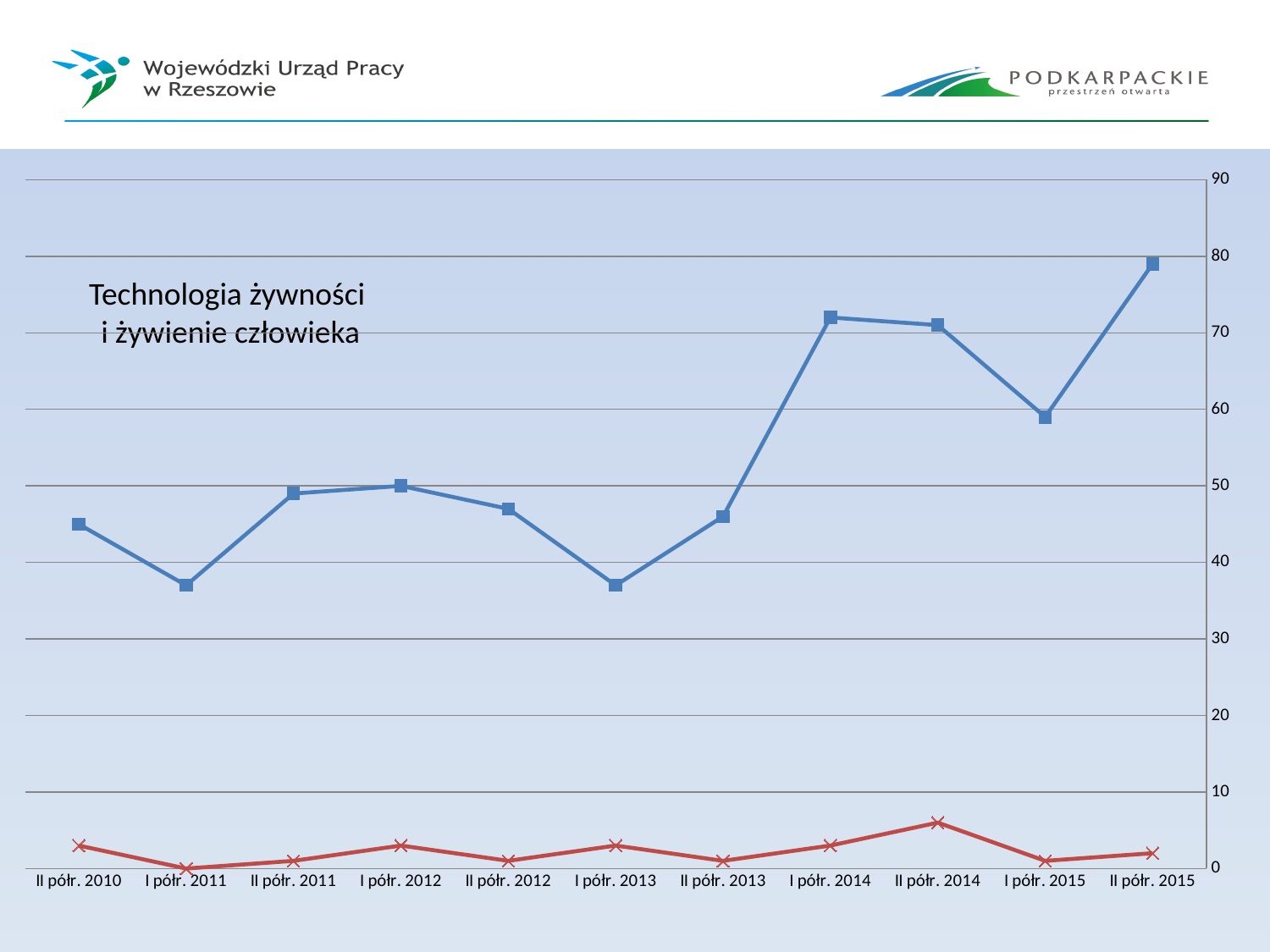
In which period does the blue line reach its highest value? II półr. 2015 Is the value of the blue line for II półr. 2015 greater or less than 70? greater On the blue line, which is larger: the value for I półr. 2014 or the value for II półr. 2013? I półr. 2014 How many data points (half-year periods) are shown along the x axis? 11 What is the title of the chart? Technologia żywności i żywienie człowieka How many lines (data series) are plotted on the chart? 2 Is the value of the blue line for I półr. 2011 greater or less than 40? less Is the value of the blue line for II półr. 2010 greater or less than 40? greater Does the blue line rise or fall between I półr. 2015 and II półr. 2015? rise What type of chart is shown on the slide? line chart In which period does the red line reach its highest value? II półr. 2014